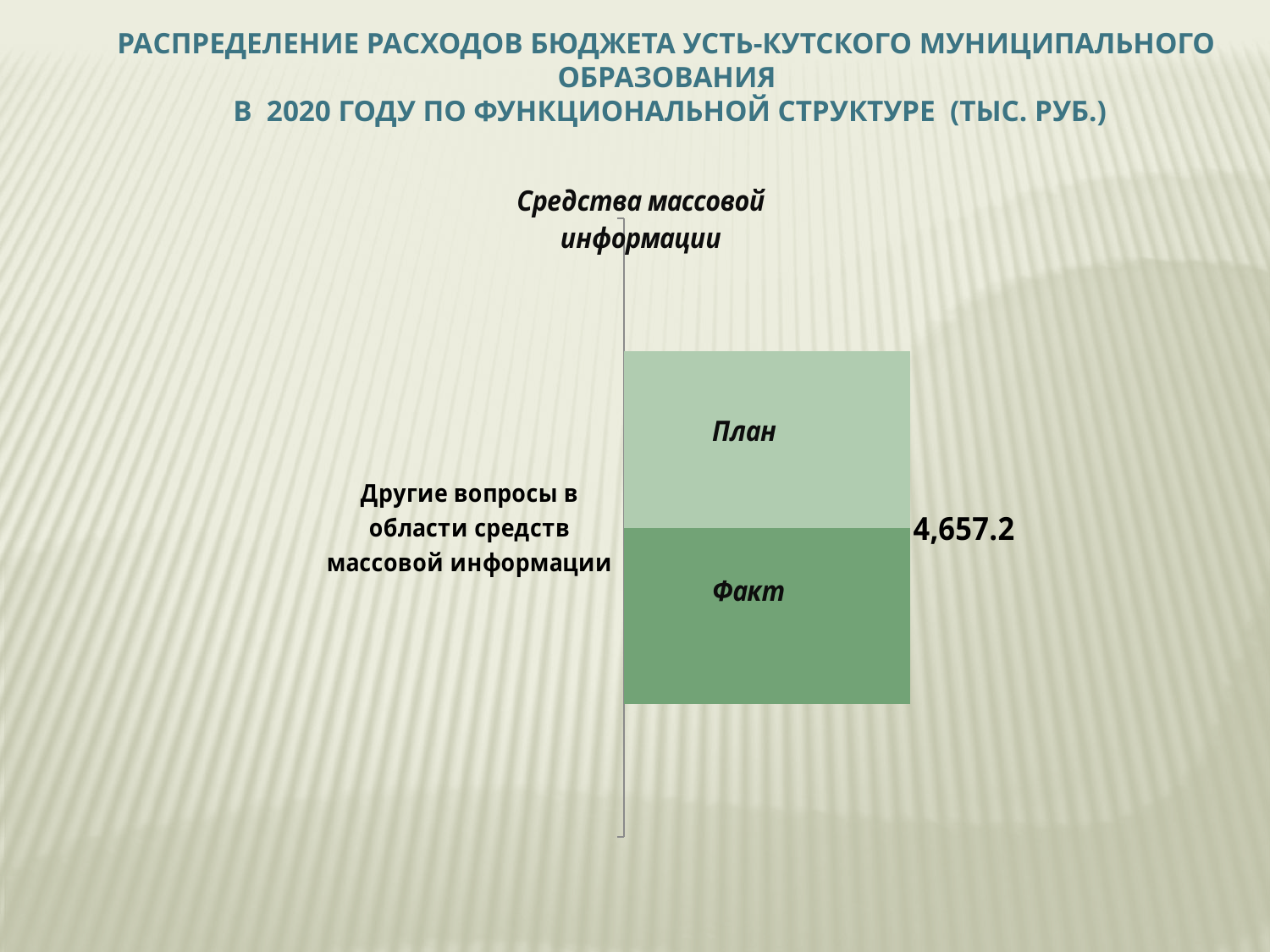
What kind of chart is shown on the slide? bar chart What is the title of the chart? Средства массовой информации What is the name of the single category shown on the chart? Другие вопросы в области средств массовой информации What value is printed as a data label on the chart? 4,657.2 How many series are plotted on the chart? 2 How many categories are plotted on the chart? 1 Which series is drawn in the darker green colour, План or Факт? Факт